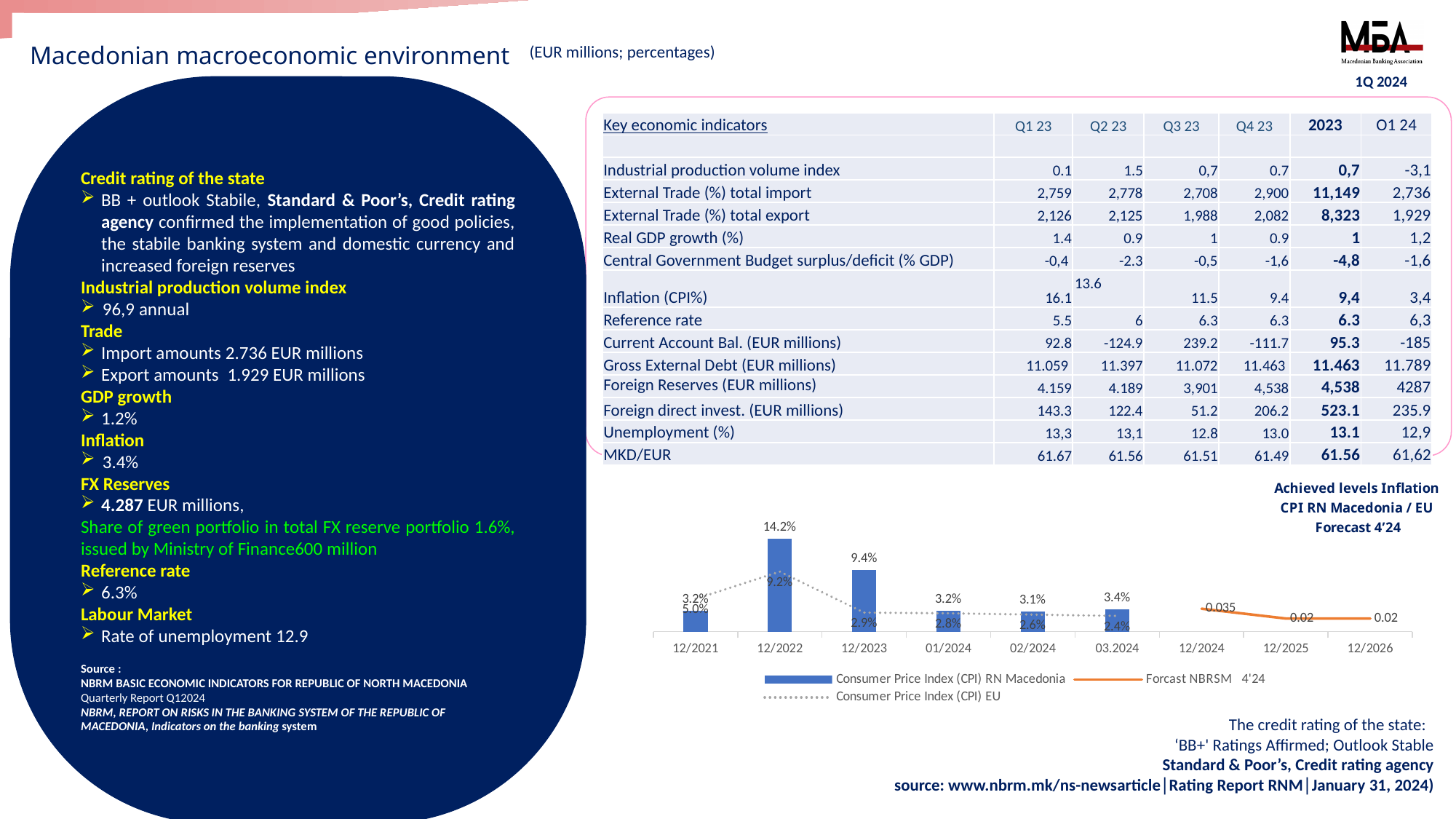
How many periods are shown on the x axis of the inflation chart? 9 How many series does the legend of the inflation chart list? 3 In the inflation chart, what is the difference between the CPI RN Macedonia values for 12/2022 and 12/2023? 4.8 percentage points What kind of chart is the inflation chart? A combined bar and line chart What is the Consumer Price Index (CPI) EU value for 12/2022 in the inflation chart? 9.2% In the inflation chart, which series is drawn as the orange line according to the legend? Forcast NBRSM 4'24 What is the Consumer Price Index (CPI) RN Macedonia value for 12/2022 in the inflation chart? 14.2% In the inflation chart, do the CPI RN Macedonia bars rise or fall from 12/2022 to 02/2024? Fall What is the Forcast NBRSM 4'24 value shown for 12/2024 in the inflation chart? 0.035 In the inflation chart, which is larger for 12/2021: the CPI RN Macedonia value or the CPI EU value? CPI EU In the inflation chart, which period has the lowest Consumer Price Index (CPI) EU value? 03.2024 In the inflation chart, which period has the highest Consumer Price Index (CPI) RN Macedonia value? 12/2022